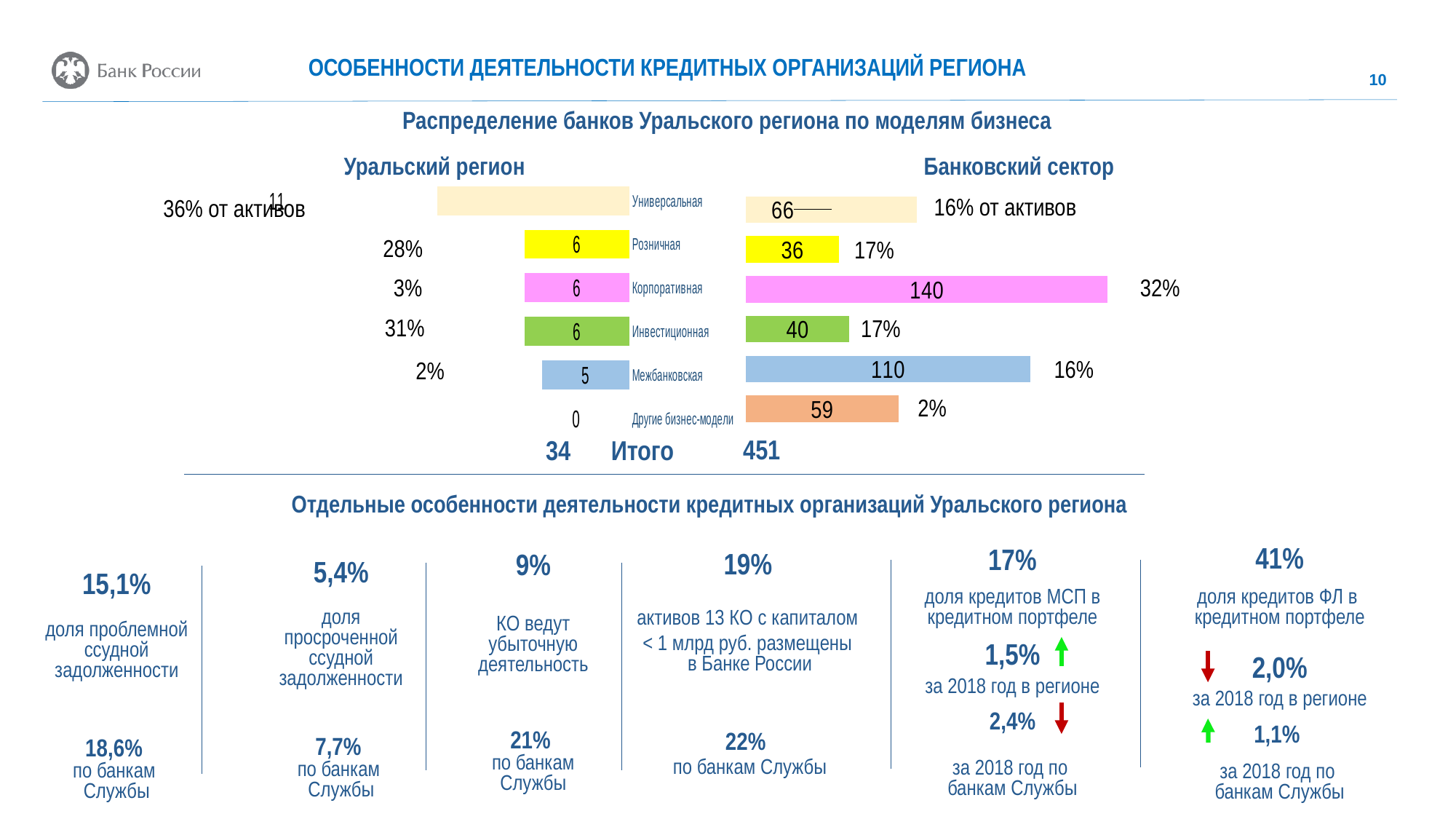
In the 'Банковский сектор' chart, what share of assets is attributed to the 'Другие бизнес-модели' category? 2% What type of chart is used to show the distribution of banks by business model? Bar chart In the 'Уральский регион' chart, how many banks have the 'Универсальная' business model? 11 In the 'Банковский сектор' chart, what is the difference between the number of banks with the 'Межбанковская' model and the 'Инвестиционная' model? 70 In the 'Банковский сектор' chart, which has more banks: 'Универсальная' or 'Розничная'? Универсальная What is the total number of banks shown for 'Уральский регион' (Итого)? 34 How many business model categories are shown in the 'Уральский регион' chart? 6 In the 'Банковский сектор' chart, which business model has the highest number of banks? Корпоративная In the 'Банковский сектор' chart, how many banks have the 'Корпоративная' business model? 140 In the 'Уральский регион' chart, which business model has the lowest number of banks? Другие бизнес-модели What is the total number of banks shown for 'Банковский сектор' (Итого)? 451 In the 'Уральский регион' chart, what share of assets is attributed to the 'Инвестиционная' business model? 31%